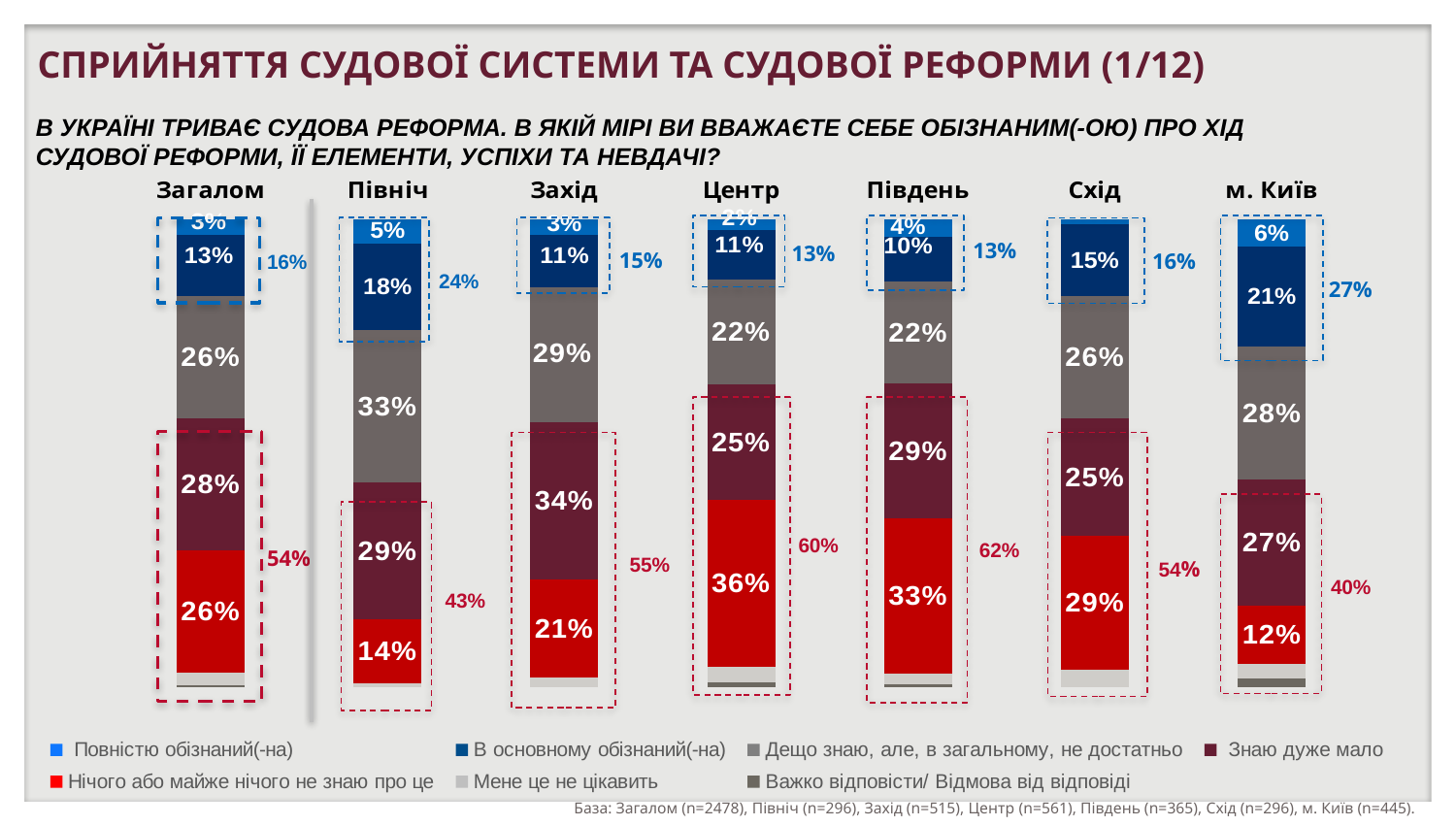
Which region has the lowest value for "Нічого або майже нічого не знаю про це"? м. Київ What is the value for "Дещо знаю, але, в загальному, не достатньо" in Північ? 33% How many series does the legend list? 7 What is the difference between the "Знаю дуже мало" values for Захід and Центр? 9% What kind of chart is shown on the slide? stacked bar chart What is the combined share of the two lowest-awareness categories (red dashed box) for Південь? 62% What is the value for "Нічого або майже нічого не знаю про це" in Центр? 36% Which region has the highest value for "Нічого або майже нічого не знаю про це"? Центр What is the value for "В основному обізнаний(-на)" in м. Київ? 21% What is the combined share of the two "обізнаний" categories (blue dashed box) for м. Київ? 27% Which is larger: the "В основному обізнаний(-на)" value for Північ or for Схід? Північ How many regional categories (bars) are shown in the chart? 7